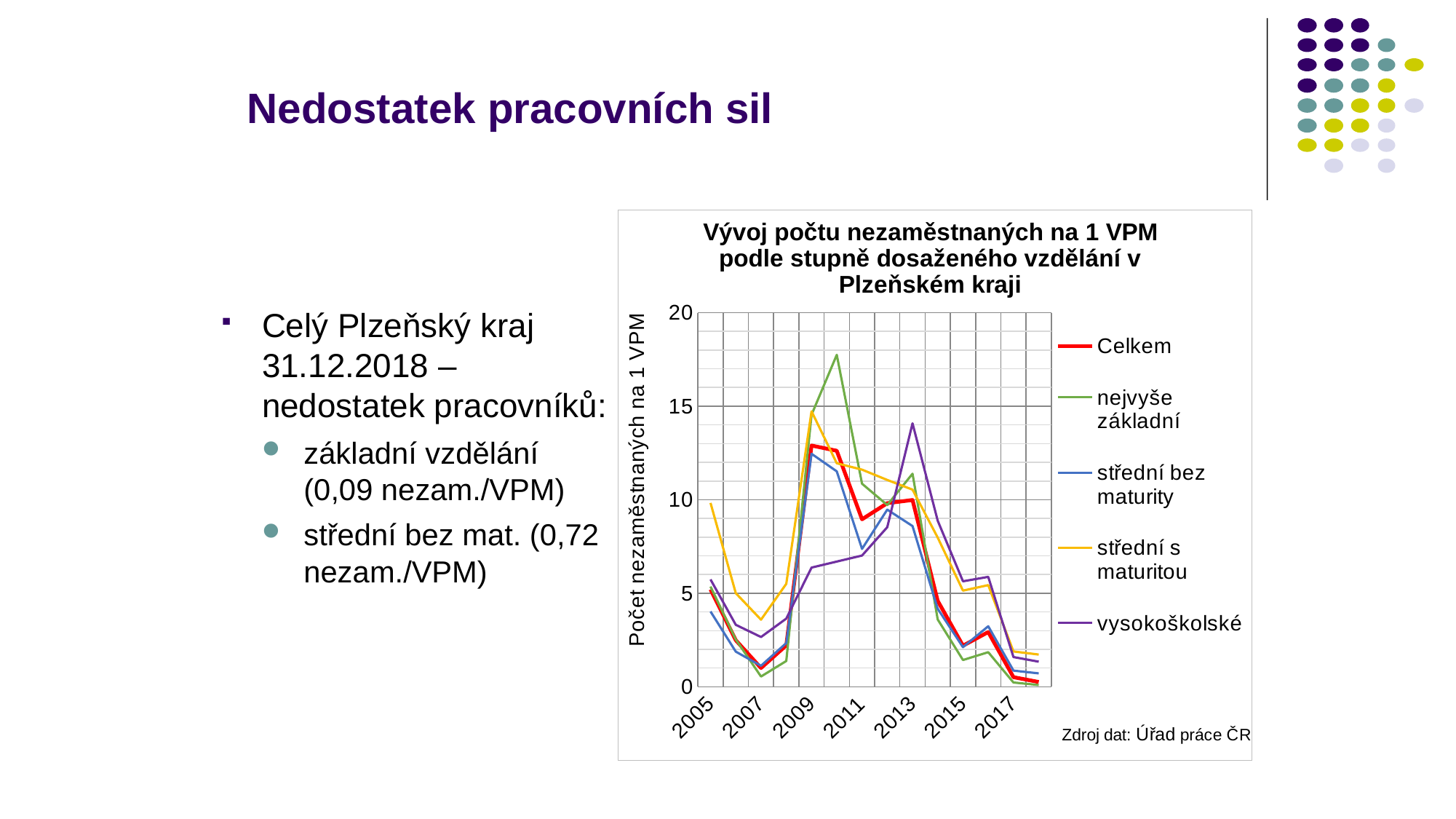
What kind of chart is shown on the slide? line chart Is the value for 'Celkem' in 2007 greater or less than 5? less How many series does the chart legend list? 5 Is the value for 'nejvyše základní' in 2010 greater or less than 15? greater Which series reaches the highest value anywhere on the chart? nejvyše základní Does the 'Celkem' line rise or fall between 2013 and 2017? fall What colour is the 'Celkem' line in the chart? red Is the value for 'vysokoškolské' in 2013 greater or less than 10? greater What is the title of the chart? Vývoj počtu nezaměstnaných na 1 VPM podle stupně dosaženého vzdělání v Plzeňském kraji In 2013, which is larger: the value for 'vysokoškolské' or for 'střední bez maturity'? vysokoškolské Which series has the lowest value in 2005? střední bez maturity Which series has the highest value in 2013? vysokoškolské